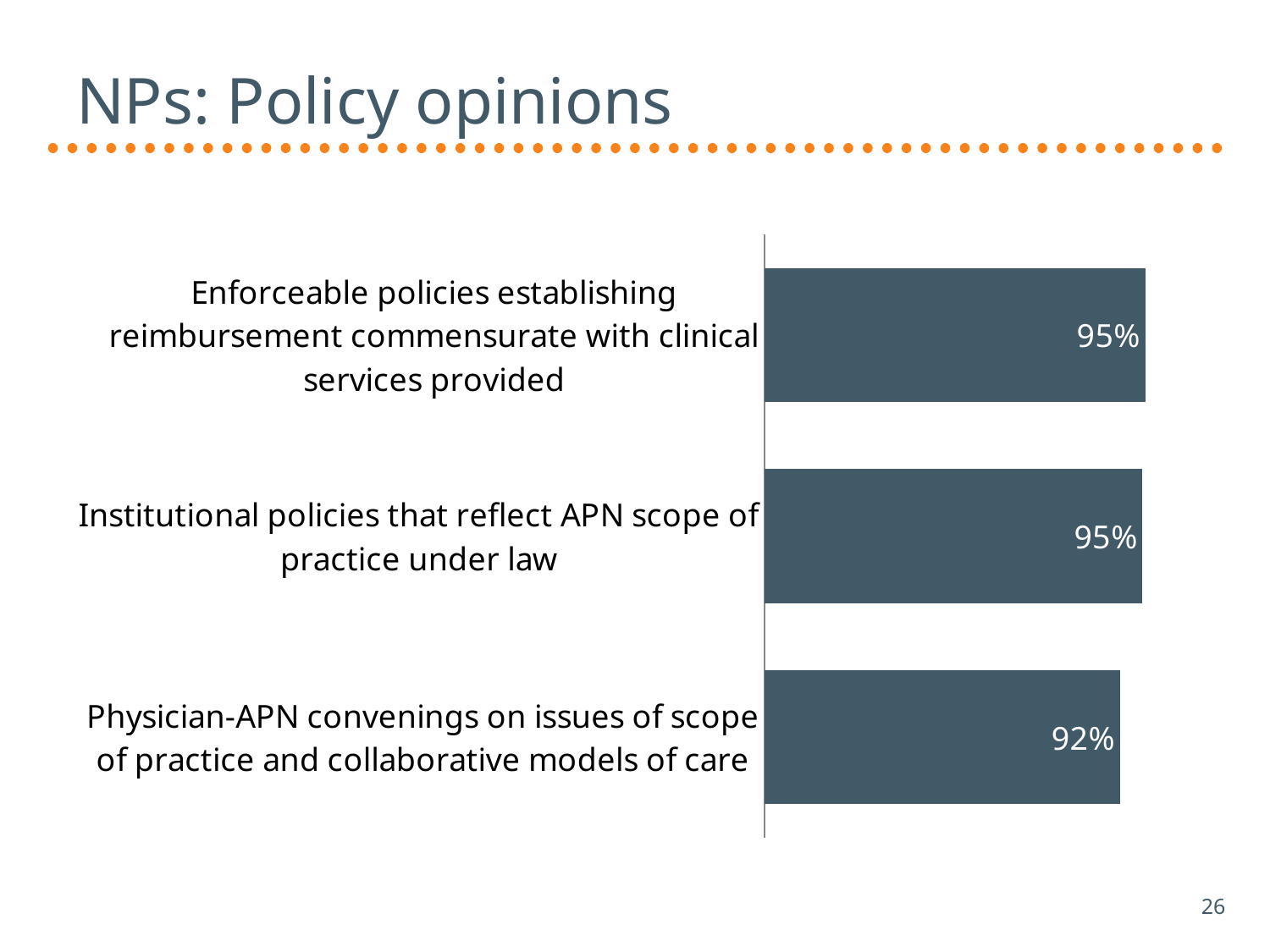
What is the title of the slide? NPs: Policy opinions What is the difference between the value for institutional policies that reflect APN scope of practice under law and the value for physician-APN convenings? 3% How many policy options are shown on the chart? 3 Which is larger: the value for enforceable reimbursement policies or the value for physician-APN convenings? Enforceable policies establishing reimbursement commensurate with clinical services provided What is the value for physician-APN convenings on issues of scope of practice and collaborative models of care? 92% What kind of chart is shown on the slide? Bar chart Are the bars on the chart horizontal or vertical? Horizontal What is the value for institutional policies that reflect APN scope of practice under law? 95% What percentage of NPs support enforceable policies establishing reimbursement commensurate with clinical services provided? 95% Which policy option has the lowest value on the chart? Physician-APN convenings on issues of scope of practice and collaborative models of care Do the values decrease from the top bar to the bottom bar? No; the top two bars are equal at 95%, and only the bottom bar is lower at 92%